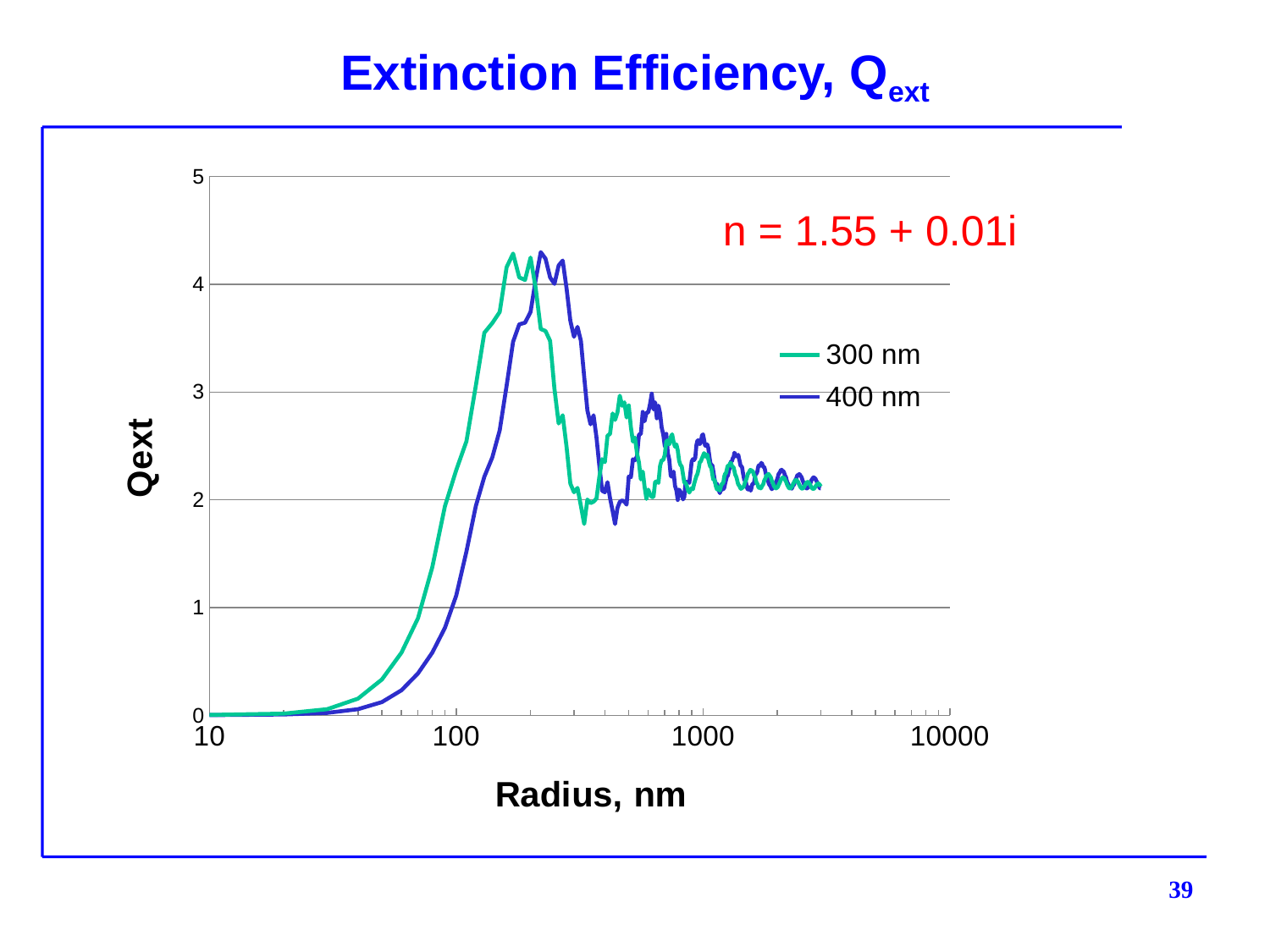
Is the peak value of the 400 nm series greater or less than 4? greater How many series does the legend list? 2 At a radius of 10 nm, is the value of the 300 nm series greater or less than 1? less Do the Qext values rise or fall as the radius increases from 10 nm to about 200 nm? rise What is the label of the x axis? Radius, nm What kind of chart is shown on the slide? Line chart What is the highest value shown on the Qext axis? 5 Is the peak value of the 300 nm series greater or less than 4? greater What are the two series named in the legend? 300 nm and 400 nm Which series reaches its peak at a smaller radius, 300 nm or 400 nm? 300 nm At a radius of 100 nm, which series has the larger Qext value, 300 nm or 400 nm? 300 nm